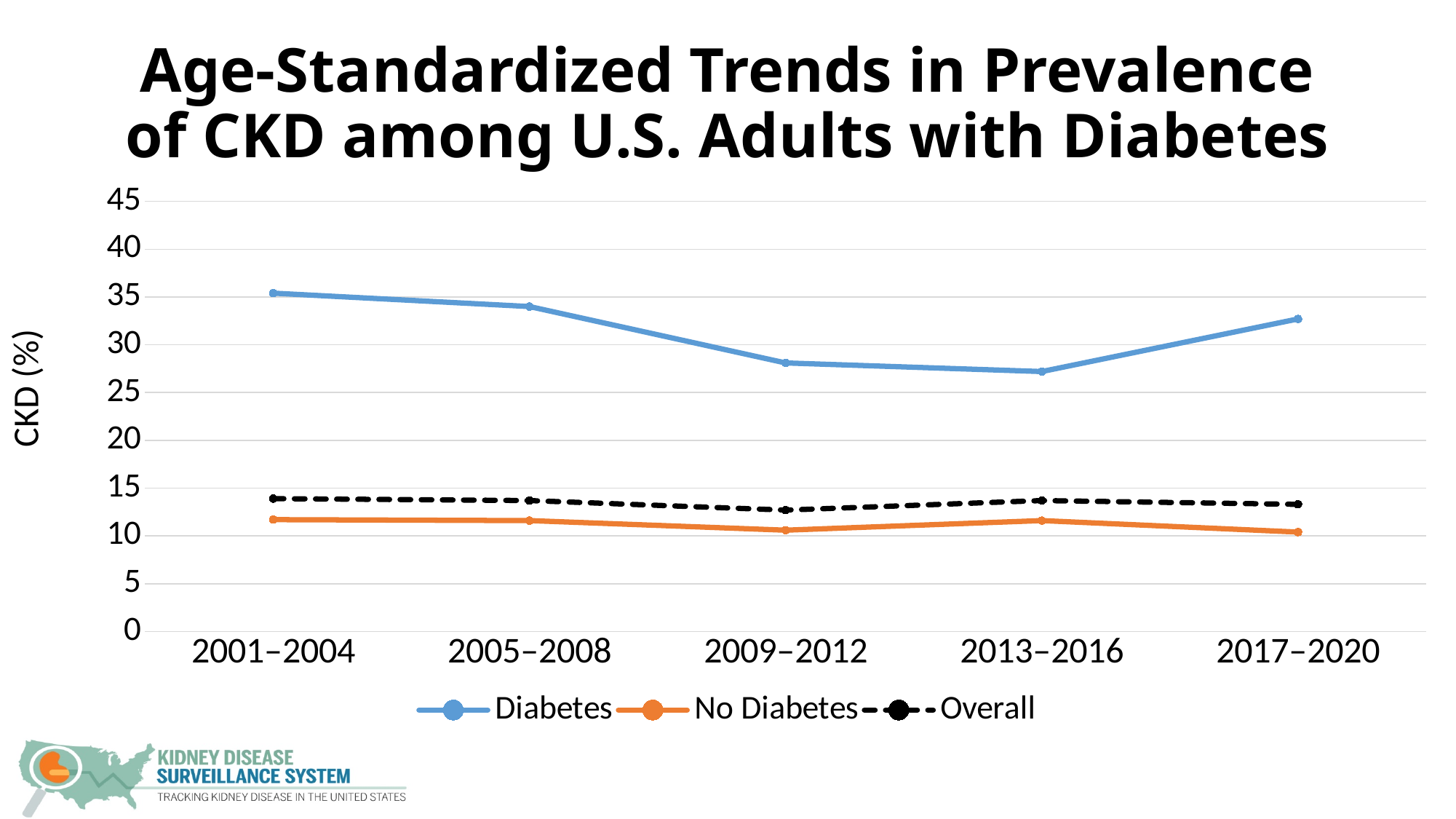
In 2017–2020, which series has the larger value, Diabetes or No Diabetes? Diabetes Is the value for Diabetes in 2001–2004 greater or less than 30? greater What kind of chart is shown on the slide? line chart For the Overall series, which period has the lowest CKD prevalence? 2009–2012 For the Diabetes series, which period has the highest CKD prevalence? 2001–2004 Does the Diabetes series rise or fall from 2001–2004 to 2013–2016? fall How many series does the legend list? 3 Is the value for No Diabetes in 2009–2012 greater or less than 15? less Is the value for Diabetes in 2013–2016 greater or less than 30? less In 2013–2016, which series has the larger value, Overall or No Diabetes? Overall What is the label on the y axis? CKD (%) How many time periods are shown on the x axis? 5